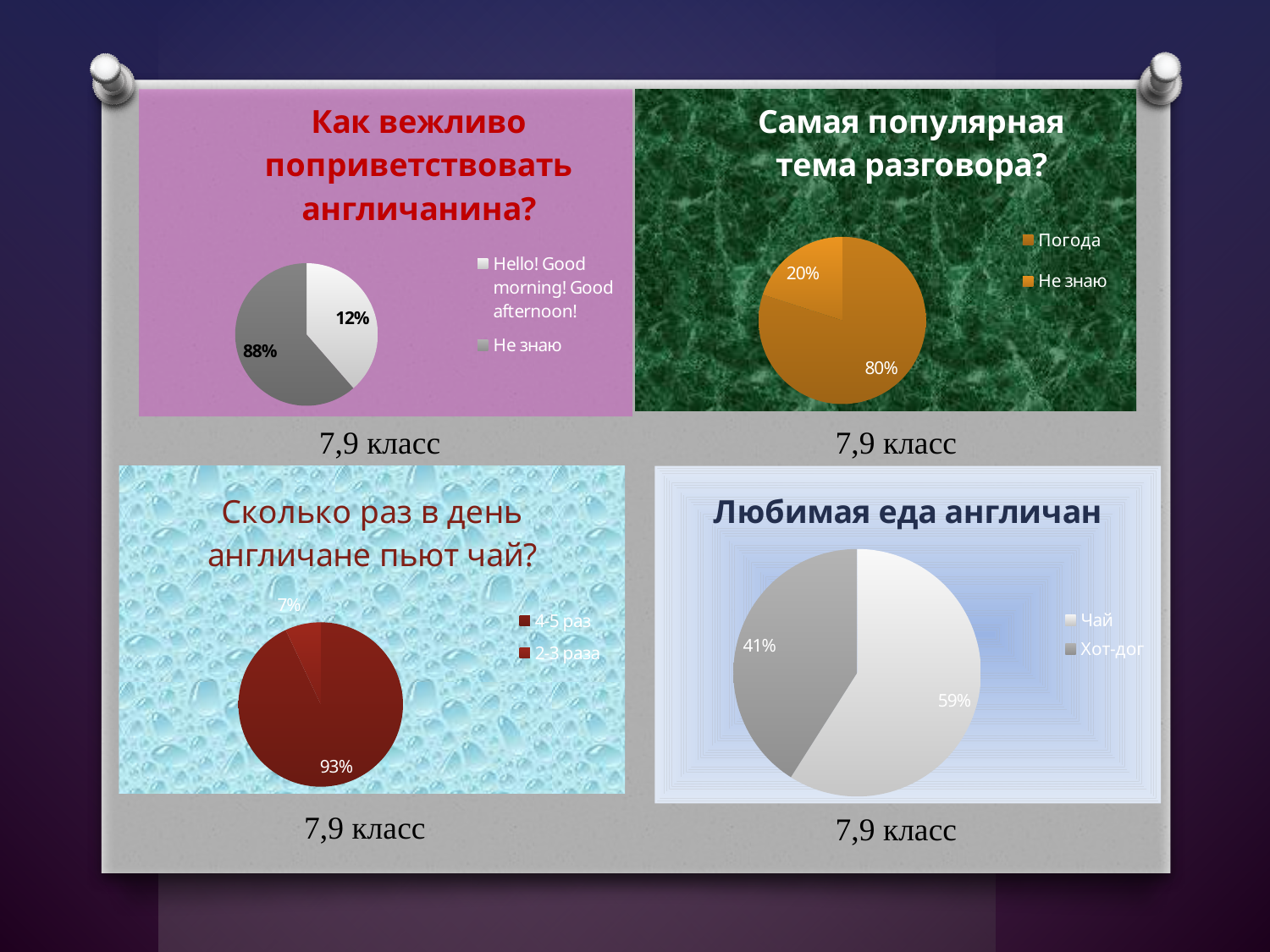
In the chart titled "Как вежливо поприветствовать англичанина?", what share of the pie is "Hello! Good morning! Good afternoon!"? 12% In the chart titled "Сколько раз в день англичане пьют чай?", what percentage is shown for "2-3 раза"? 7% In the chart titled "Как вежливо поприветствовать англичанина?", what is the difference between the two slices? 76% In the chart titled "Самая популярная тема разговора?", what percentage is shown for "Погода"? 80% In the chart titled "Как вежливо поприветствовать англичанина?", what percentage is shown for "Не знаю"? 88% In the chart titled "Любимая еда англичан", what is the difference between "Чай" and "Хот-дог"? 18% In the chart titled "Любимая еда англичан", which is larger, "Чай" or "Хот-дог"? Чай In the chart titled "Самая популярная тема разговора?", which category has the smallest slice? Не знаю In the chart titled "Сколько раз в день англичане пьют чай?", what share of the pie is "4-5 раз"? 93% What kind of chart is used in the bottom-right chart titled "Любимая еда англичан"? Pie chart In the chart titled "Самая популярная тема разговора?", how many entries does the legend list? 2 In the chart titled "Любимая еда англичан", what percentage is shown for "Хот-дог"? 41%